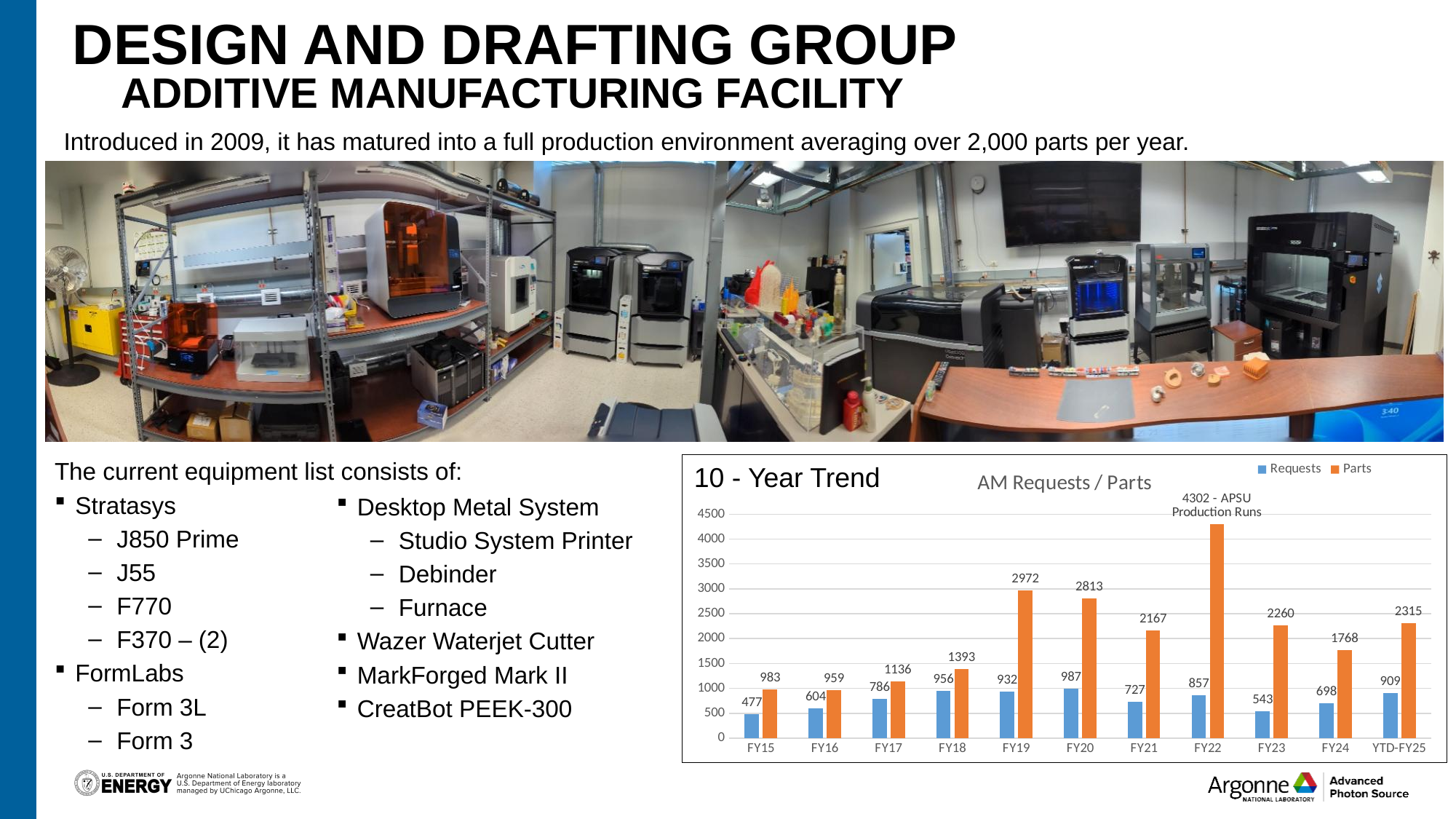
How many series does the legend list? 2 Which is larger, Requests in FY18 or Requests in FY19? Requests in FY18 Which fiscal year has the lowest value for Requests? FY15 Is the value for Parts in FY24 greater or less than 1500? greater What is the value for Requests in FY15? 477 What is the difference between Parts in FY20 and Parts in FY21? 646 What is the value for Parts in YTD-FY25? 2315 How many fiscal year categories are shown on the x axis? 11 What kind of chart is shown on the slide? Bar chart What is the title of the chart? AM Requests / Parts Which fiscal year has the highest value for Parts? FY22 What is the value for Parts in FY19? 2972